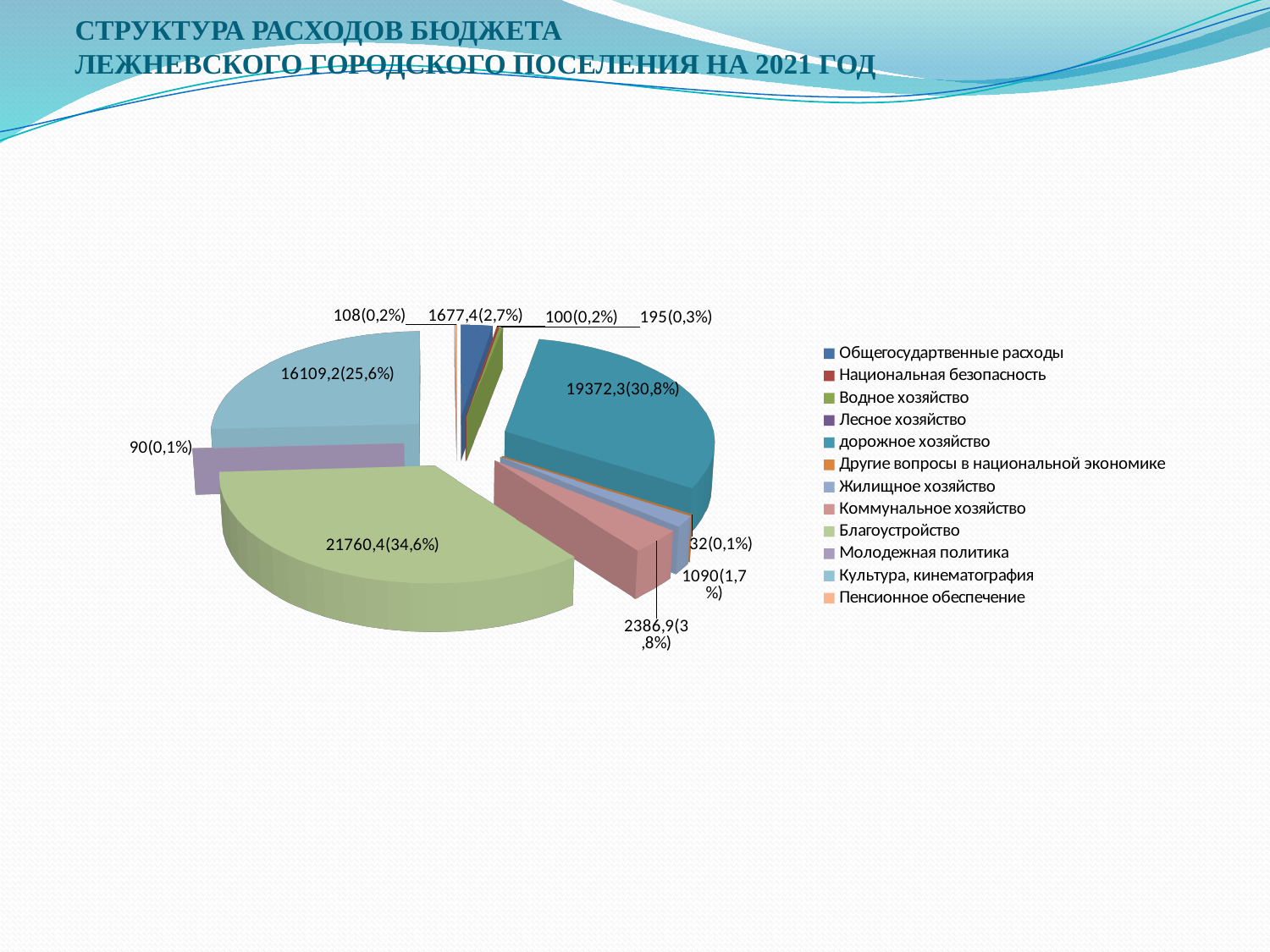
What is the title of the slide containing the pie chart? СТРУКТУРА РАСХОДОВ БЮДЖЕТА ЛЕЖНЕВСКОГО ГОРОДСКОГО ПОСЕЛЕНИЯ НА 2021 ГОД Which category has the largest slice of the pie chart? Благоустройство What value is shown for the Благоустройство slice? 21760,4(34,6%) What share of the pie does Коммунальное хозяйство account for? 3,8% What value is shown for the дорожное хозяйство slice? 19372,3(30,8%) Which is larger, the slice for дорожное хозяйство or the slice for Культура, кинематография? дорожное хозяйство What kind of chart is shown on the slide? pie chart How many categories does the legend of the pie chart list? 12 What value is shown for the Культура, кинематография slice? 16109,2(25,6%) What is the difference between the values for Благоустройство and дорожное хозяйство? 2388,1 What value is shown for the Молодежная политика slice? 90(0,1%) What share of the pie does Благоустройство account for? 34,6%